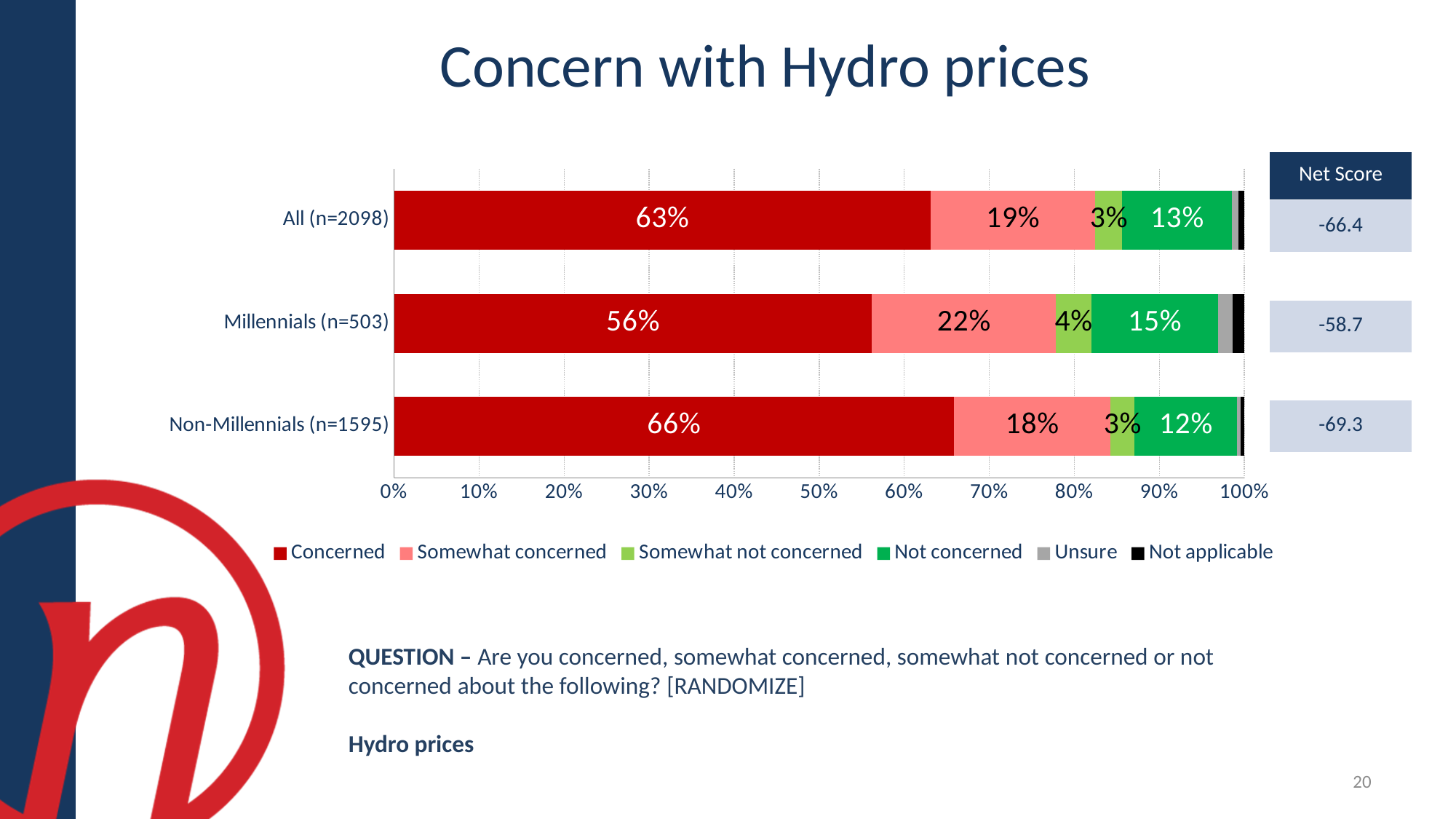
How many groups are shown on the chart? 3 What percentage of Non-Millennials (n=1595) are Not concerned? 12% Which group has the highest Concerned percentage? Non-Millennials (n=1595) Which group has the lowest Concerned percentage? Millennials (n=503) What percentage of All (n=2098) respondents are Concerned about hydro prices? 63% What kind of chart is shown on the slide? Stacked bar chart Is the Concerned value for Millennials (n=503) greater or less than 50%? greater What is the difference between the Concerned percentage for Non-Millennials (n=1595) and Millennials (n=503)? 10% Which is larger: the Not concerned percentage for Millennials (n=503) or for All (n=2098)? Millennials (n=503) What is the Net Score for Millennials (n=503)? -58.7 How many series does the legend list? 6 What percentage of Millennials (n=503) are Somewhat concerned? 22%